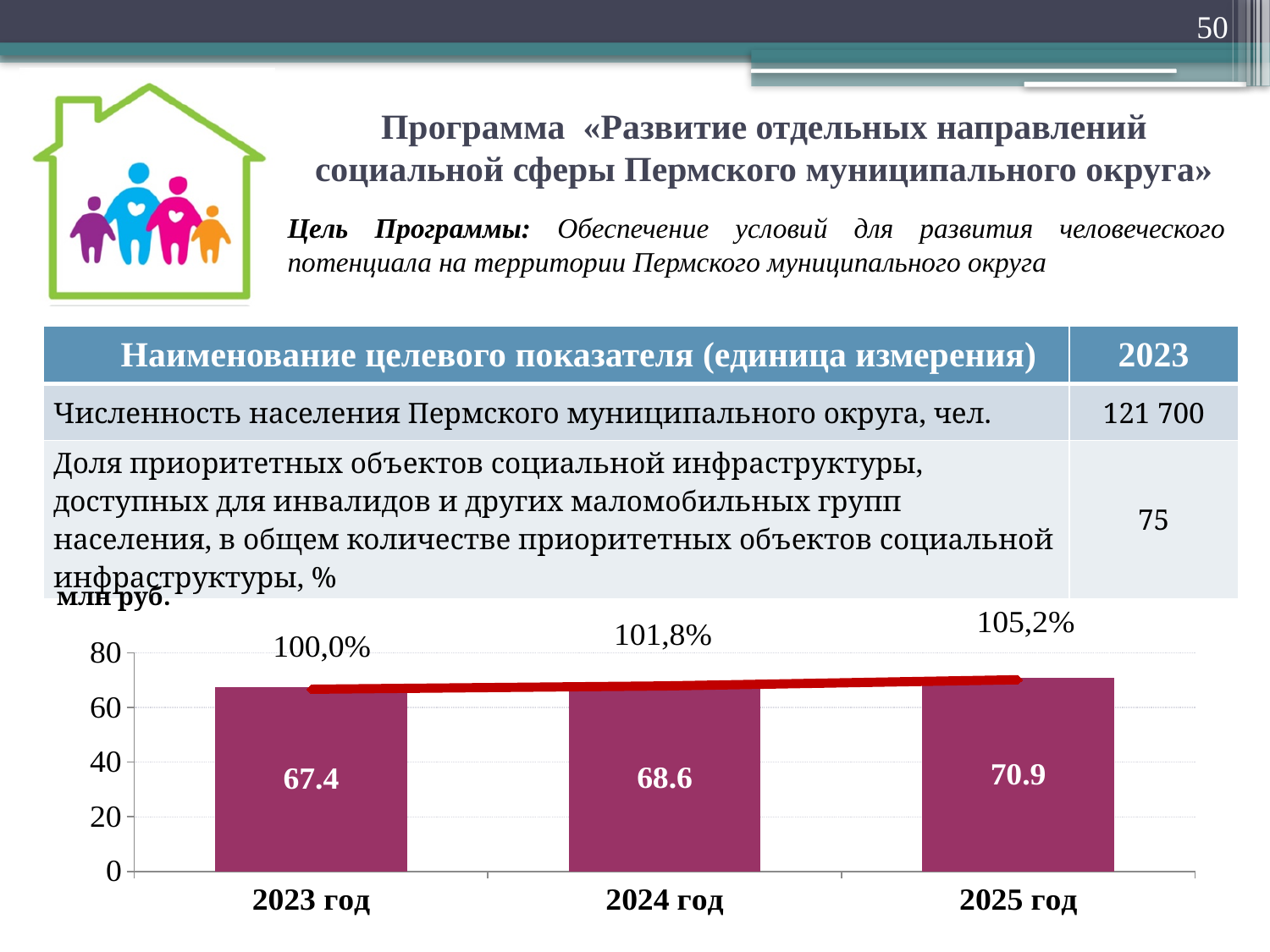
What kind of chart is shown at the bottom of the slide? combination bar and line chart What is the value for 2025 год in the bar chart? 70.9 Is the value for 2025 год greater or less than 60? greater Which is larger, the value for 2024 год or the value for 2023 год? 2024 год Do the bar values rise or fall from 2023 год to 2025 год? rise What is the difference between the values for 2025 год and 2023 год? 3.5 What is the value for 2024 год in the bar chart? 68.6 What is the value for 2023 год in the bar chart? 67.4 What percentage label is shown above the 2025 год bar? 105,2% How many bars are shown in the chart? 3 Which year has the highest bar in the chart? 2025 год Which year has the lowest bar in the chart? 2023 год